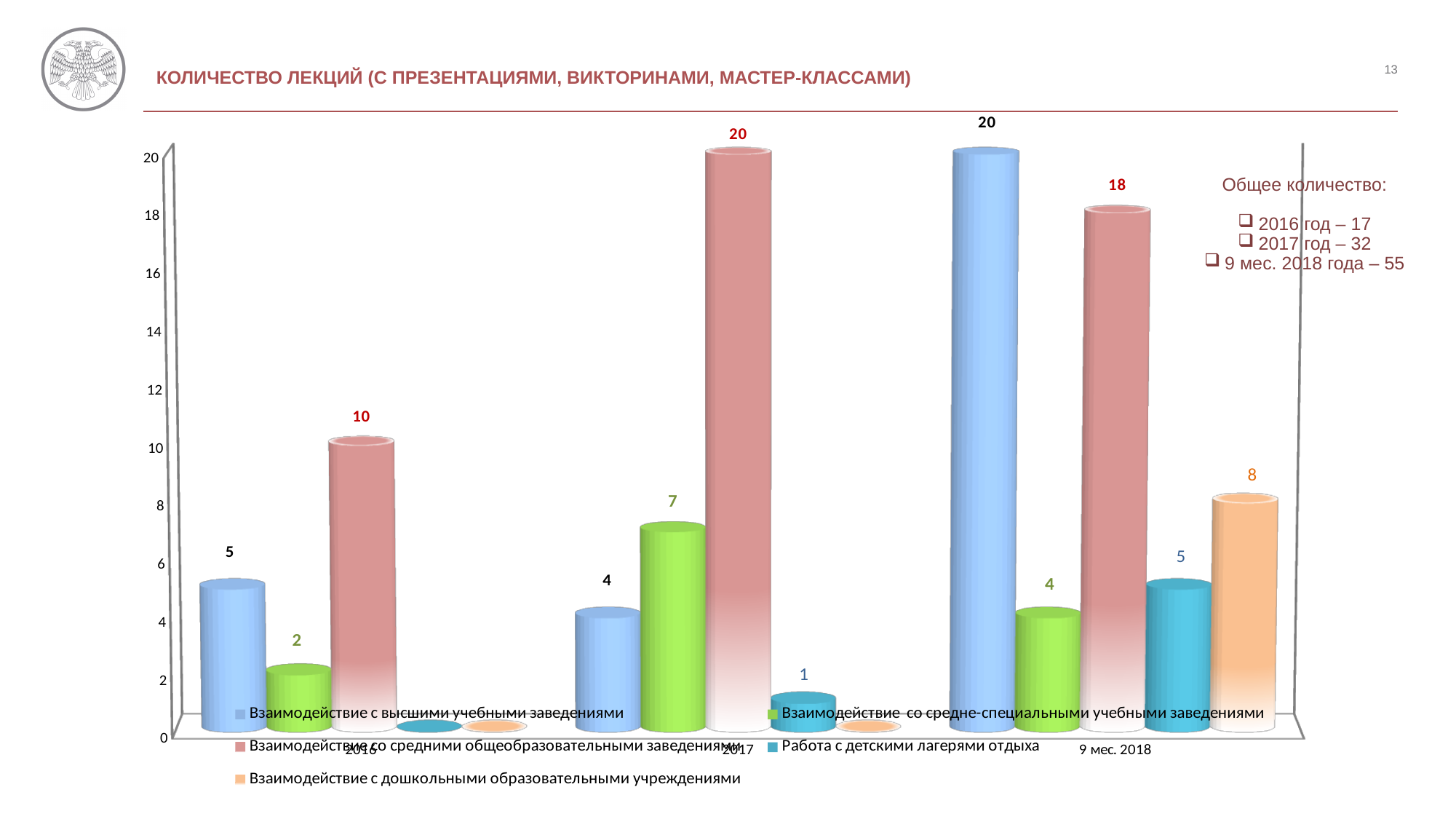
Which series has the highest value in 2016? Взаимодействие со средними общеобразовательными заведениями What is the difference between the values for "Взаимодействие со средними общеобразовательными заведениями" in 2017 and in 9 мес. 2018? 2 What is the value for "Взаимодействие с высшими учебными заведениями" in 2016? 5 What kind of chart is shown on the slide? bar chart What is the value for "Взаимодействие со средними общеобразовательными заведениями" in 2017? 20 Which is larger: the value for "Взаимодействие со средне-специальными учебными заведениями" in 2017 or in 9 мес. 2018? 2017 How many series does the legend list? 5 What is the value for "Взаимодействие с дошкольными образовательными учреждениями" in 9 мес. 2018? 8 According to the text on the slide, what is the total number of lectures for 2017? 32 How many categories are shown on the x axis? 3 What is the value for "Работа с детскими лагерями отдыха" in 2017? 1 Which series has the highest value in 9 мес. 2018? Взаимодействие с высшими учебными заведениями